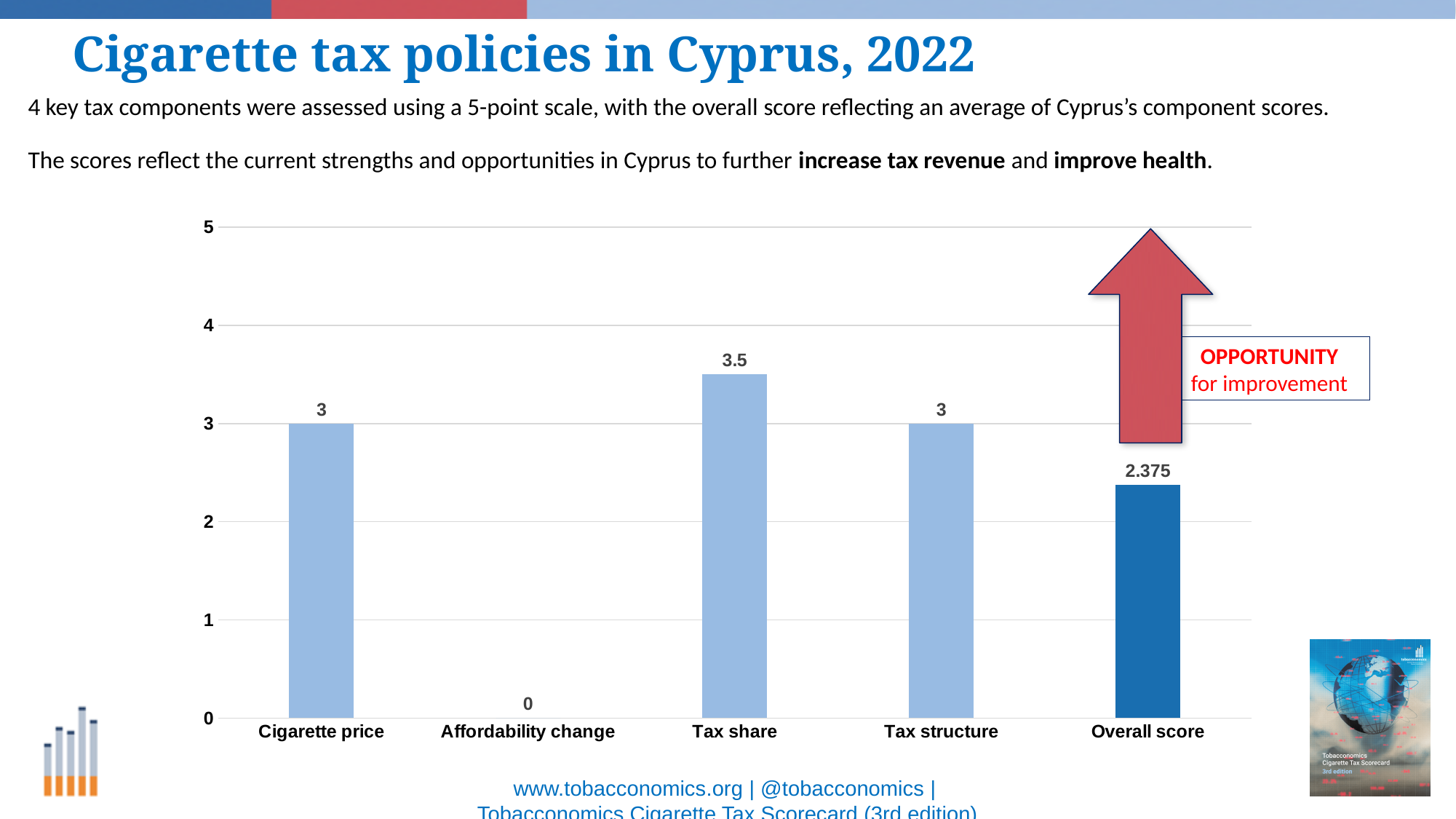
What is the value for Overall score? 2.375 What kind of chart is shown on the slide? bar chart What is the maximum value shown on the y axis? 5 How many categories are shown on the x axis? 5 What is the value for Affordability change? 0 What is the value for Tax share? 3.5 Is the value for Overall score greater or less than 3? less Which is larger, the value for Cigarette price or the value for Overall score? Cigarette price What is the value for Cigarette price? 3 Which category has the lowest value? Affordability change Which category has the highest value? Tax share What is the difference between the values for Tax share and Tax structure? 0.5